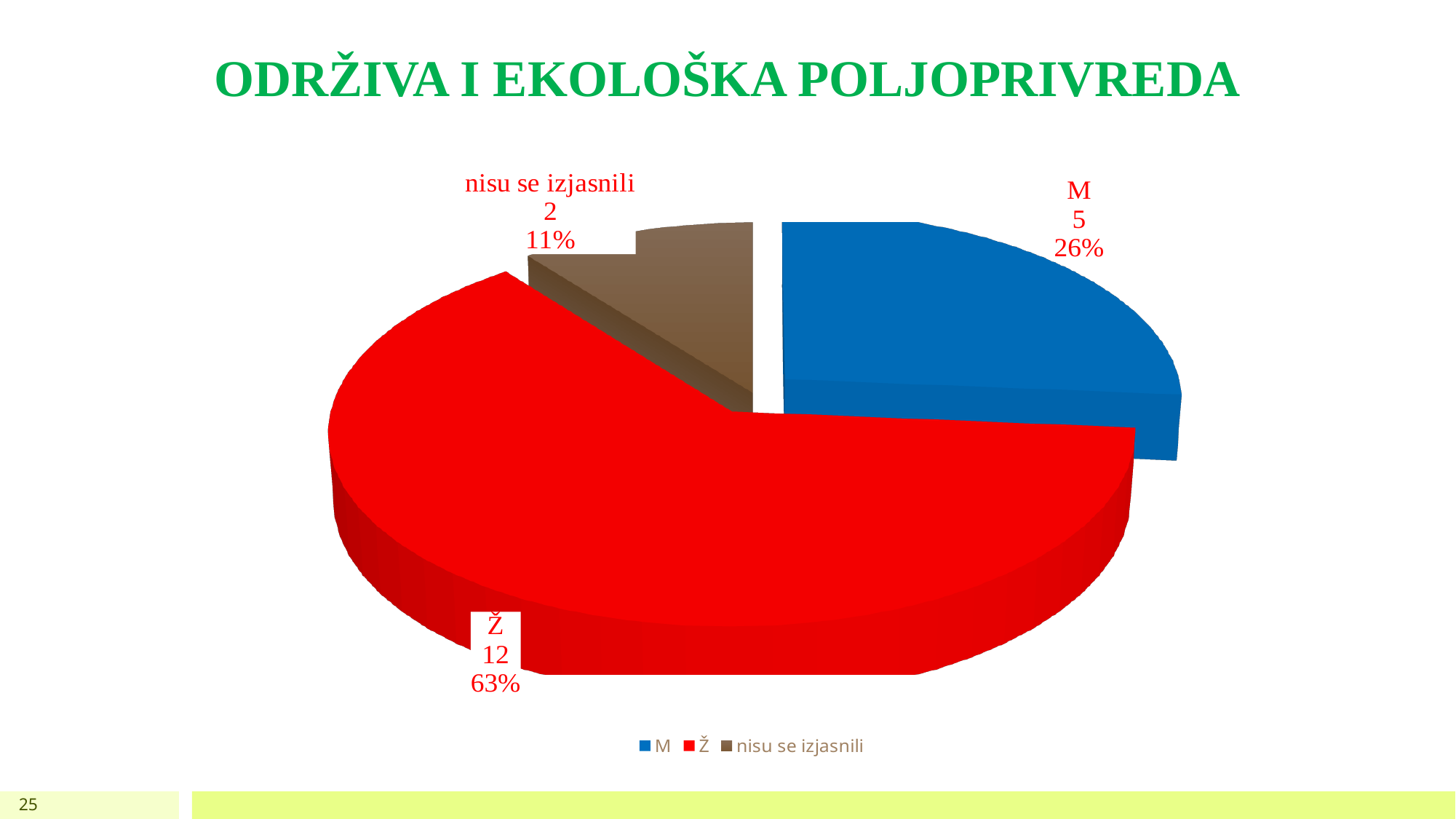
How many categories does the pie chart have? 3 What is the value for 'nisu se izjasnili'? 2 Which category has the smallest slice? nisu se izjasnili What is the value for M? 5 What share of the pie does M represent? 26% Which is larger, the value for M or the value for 'nisu se izjasnili'? M What is the value for Ž? 12 What kind of chart is shown on the slide? pie chart What share of the pie does Ž represent? 63% What is the difference between the values for Ž and M? 7 What share of the pie does 'nisu se izjasnili' represent? 11% Which category has the largest slice? Ž